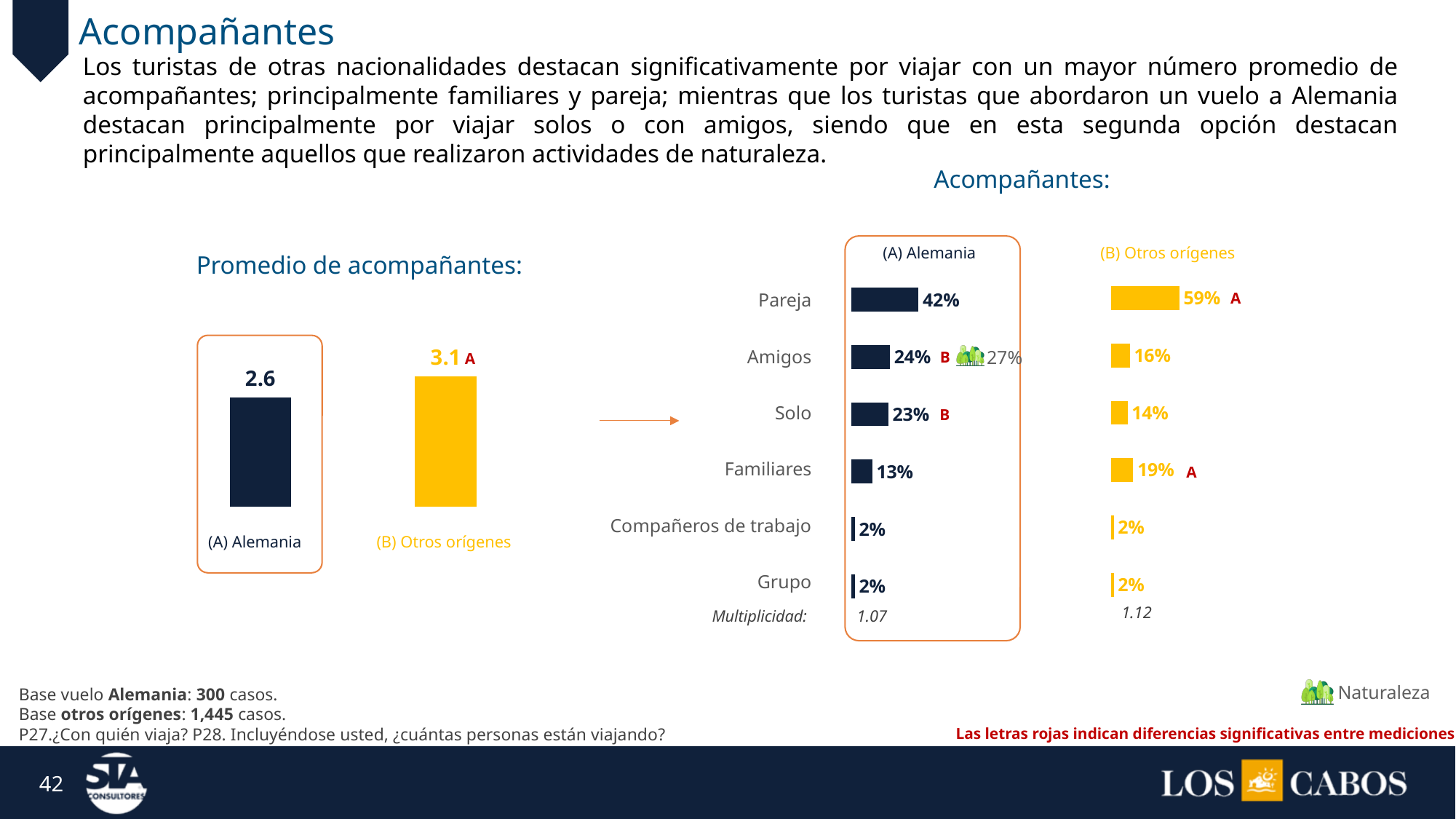
In the 'Acompañantes:' chart, which category is highest for (B) Otros orígenes? Pareja In the 'Acompañantes:' chart, what percentage of (A) Alemania travel with Pareja? 42% In the 'Acompañantes:' chart, what is the Multiplicidad value for (A) Alemania? 1.07 In the 'Acompañantes:' chart, what is the difference between (B) Otros orígenes and (A) Alemania for Pareja? 17% What kind of chart is the 'Promedio de acompañantes' chart? Bar chart In the 'Promedio de acompañantes' chart, what is the value for (B) Otros orígenes? 3.1 In the 'Acompañantes:' chart, which is larger for Solo: (A) Alemania or (B) Otros orígenes? (A) Alemania In the 'Promedio de acompañantes' chart, what is the difference between (B) Otros orígenes and (A) Alemania? 0.5 How many categories are shown in the 'Acompañantes:' chart? 6 In the 'Promedio de acompañantes' chart, what is the value for (A) Alemania? 2.6 In the 'Promedio de acompañantes' chart, which category has the higher average? (B) Otros orígenes In the 'Acompañantes:' chart, what percentage of (B) Otros orígenes travel with Familiares? 19%